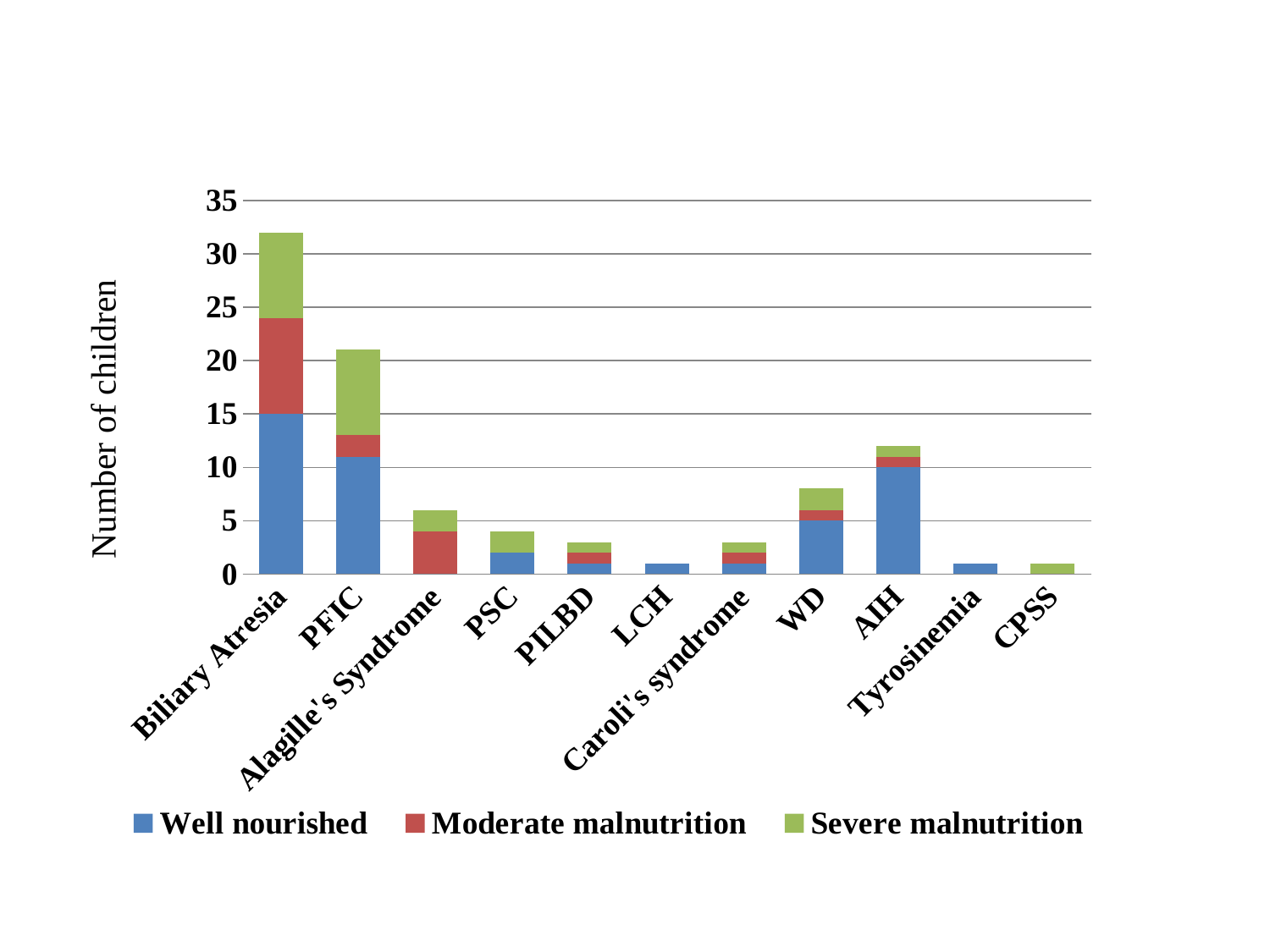
What is the label on the y axis? Number of children How many disease categories are shown on the x axis? 11 Is the total bar height for Alagille's Syndrome greater or less than 5? greater How many well nourished children are shown for AIH? 10 How many well nourished children are shown for Biliary Atresia? 15 Which has more well nourished children, Biliary Atresia or PFIC? Biliary Atresia What kind of chart is shown on the slide? Stacked bar chart How many well nourished children are shown for WD? 5 Is the total bar height for PFIC greater or less than 20? greater How many series does the legend list? 3 Which category has the tallest bar overall? Biliary Atresia Which has a taller total bar, PFIC or AIH? PFIC